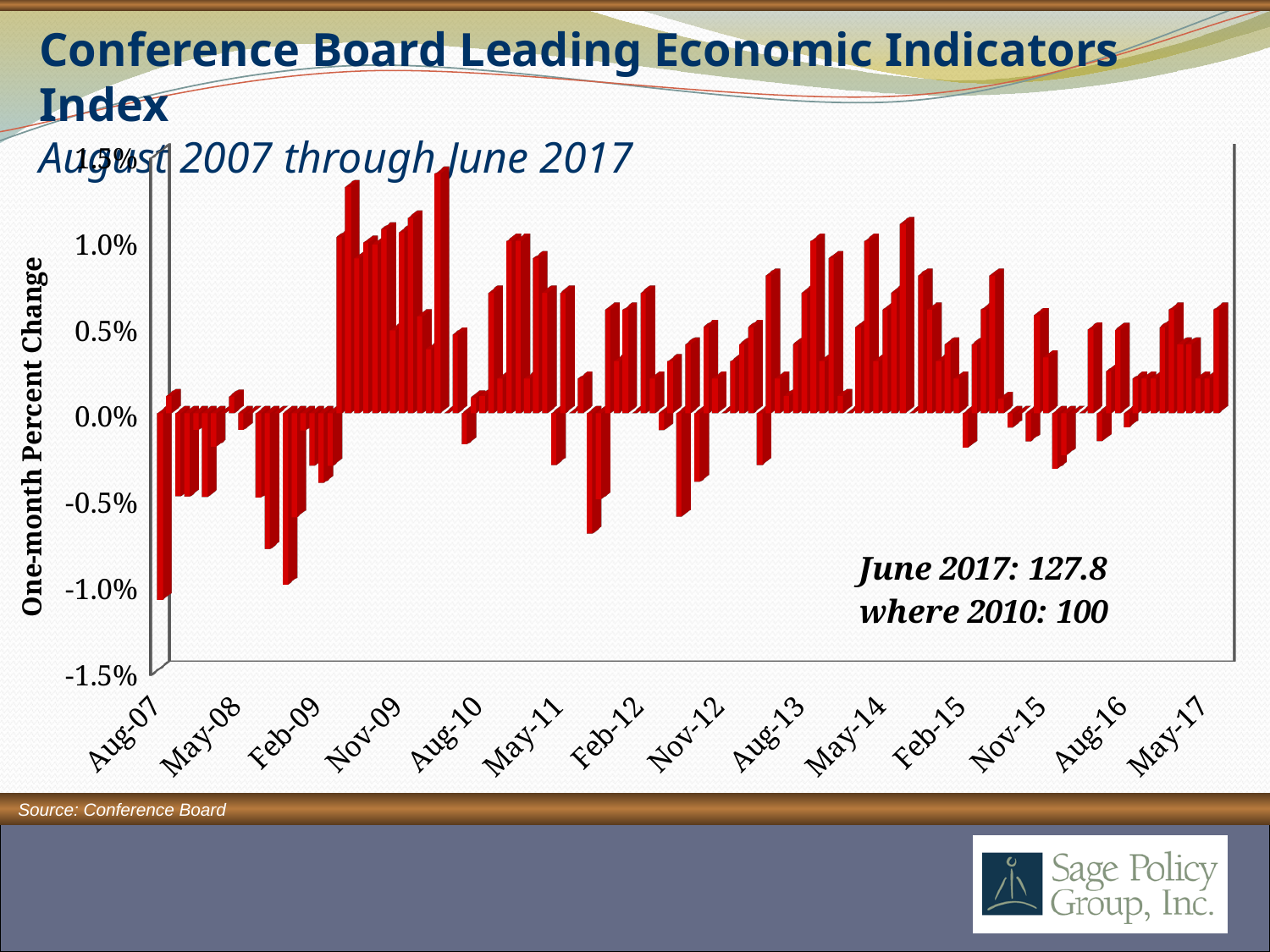
Is the value for Aug-07, the first bar on the chart, greater or less than -0.5%? less What is the highest value shown on the vertical axis of the chart? 1.5% What is the label on the vertical axis of the chart? One-month Percent Change What kind of chart is shown on the slide? Bar chart What is the lowest value shown on the vertical axis of the chart? -1.5% Is the value for Aug-07, the first bar on the chart, greater or less than 0.0%? less What period does the chart cover, according to the subtitle? August 2007 through June 2017 What is the source cited for the chart? Conference Board How many date labels are shown along the x axis of the chart? 14 According to the annotation on the chart, what was the index value in June 2017? 127.8 What is the title of the chart on the slide? Conference Board Leading Economic Indicators Index According to the annotation on the chart, what is the base year value of the index? 2010: 100